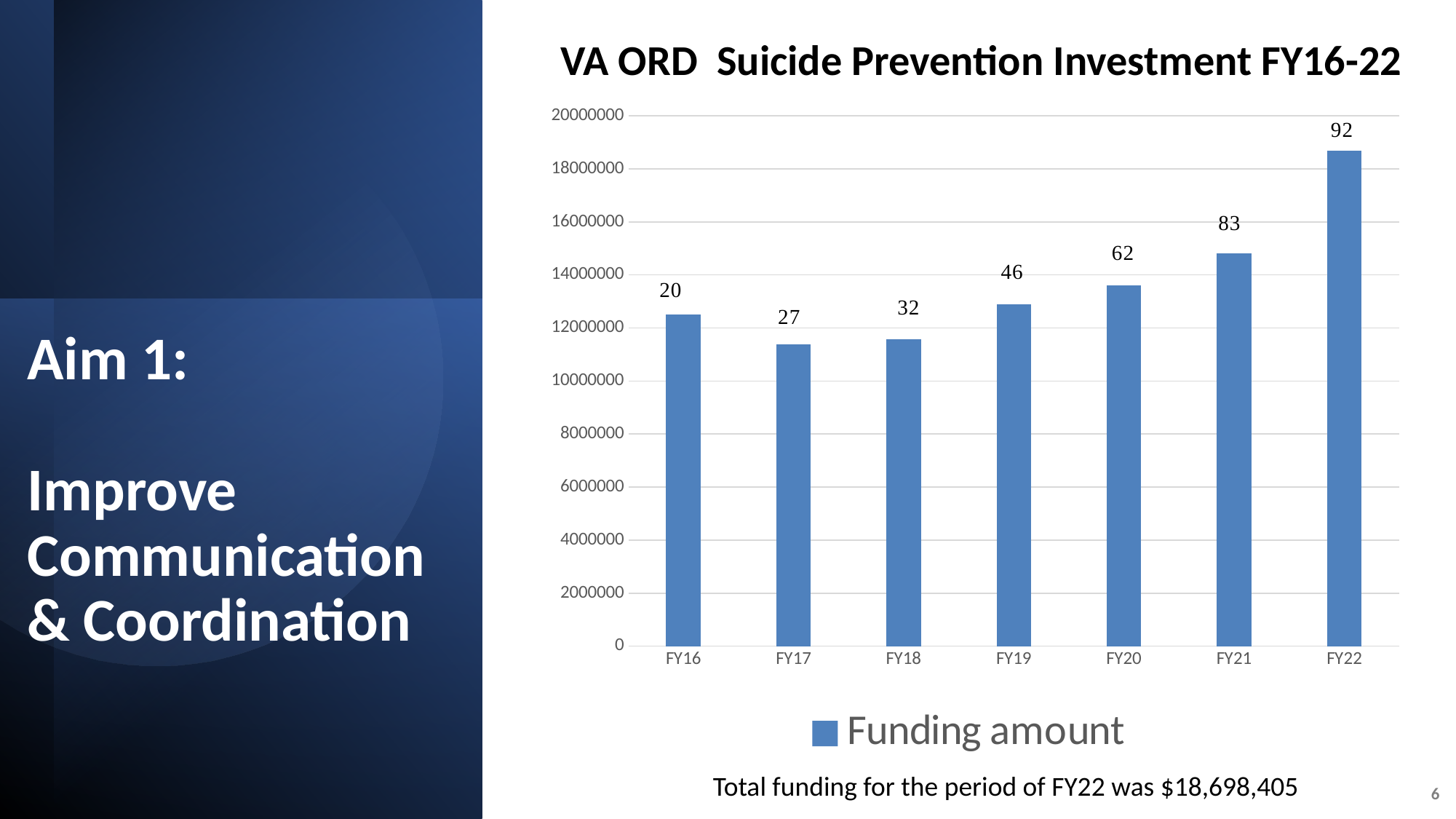
How many fiscal years (categories) are shown on the x axis of the chart? 7 What is the name of the series shown in the chart's legend? Funding amount What is the title of the chart? VA ORD Suicide Prevention Investment FY16-22 What data label is printed above the FY22 bar? 92 What type of chart is shown on the slide? bar chart What data label is printed above the FY20 bar? 62 What data label is printed above the FY16 bar? 20 Which bar is taller, FY16 or FY21? FY21 Is the bar for FY17 greater or less than 12000000? less Which fiscal year has the tallest bar in the chart? FY22 Is the bar for FY22 greater or less than 18000000? greater How many series does the chart's legend list? 1